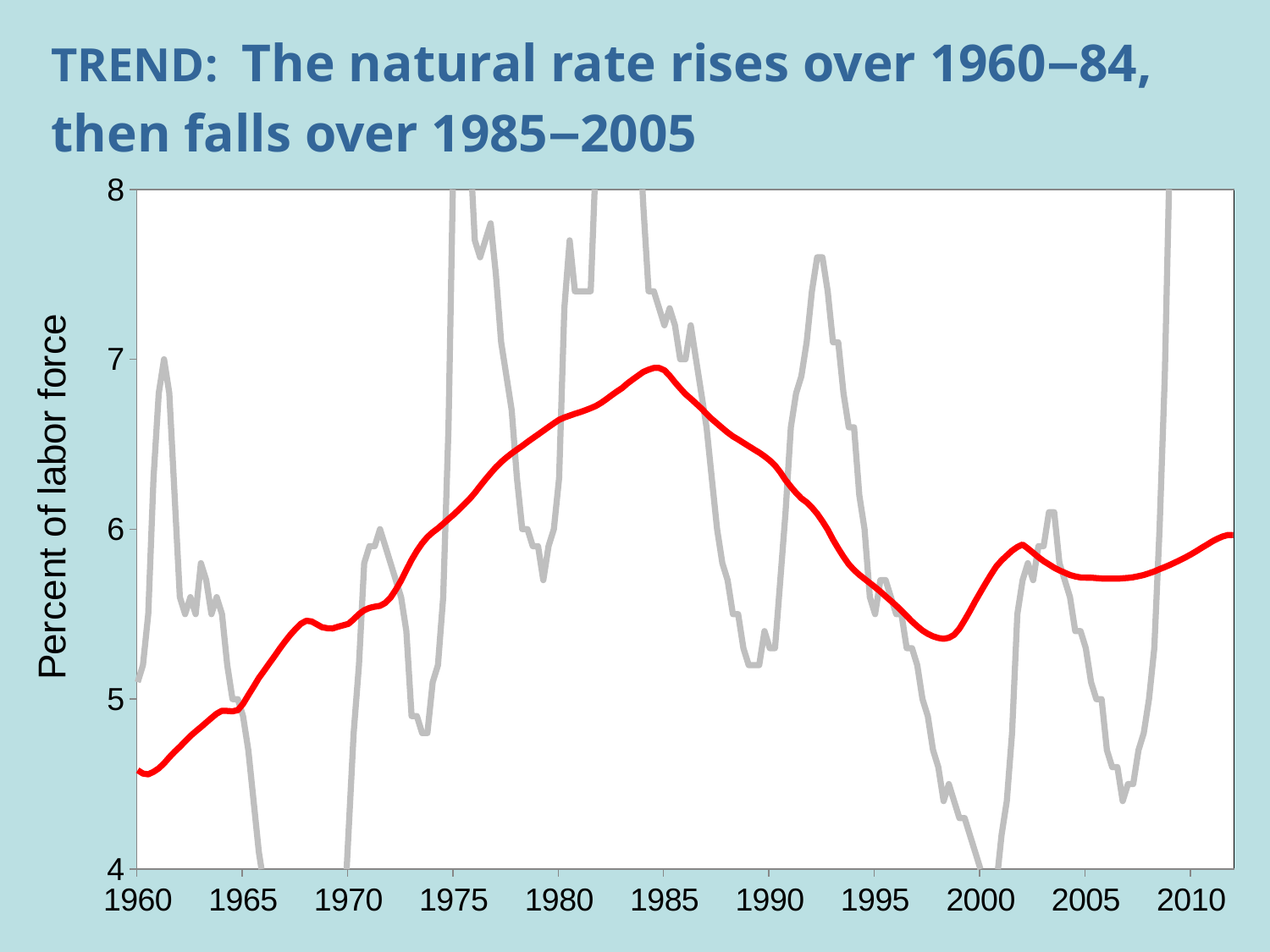
Is the value of the red line in 1960 greater or less than 5? less What is the label of the vertical axis? Percent of labor force Does the red line rise or fall between 1960 and 1984? rise Is the value of the red line in 2010 greater or less than 6? less What kind of chart is shown on the slide? line chart Is the value of the red line in 1985 greater or less than 6? greater What is the title of the slide? TREND: The natural rate rises over 1960–84, then falls over 1985–2005 Which line reaches a higher value in 1975, the red line or the gray line? the gray line Does the red line rise or fall between 1985 and 2005? fall